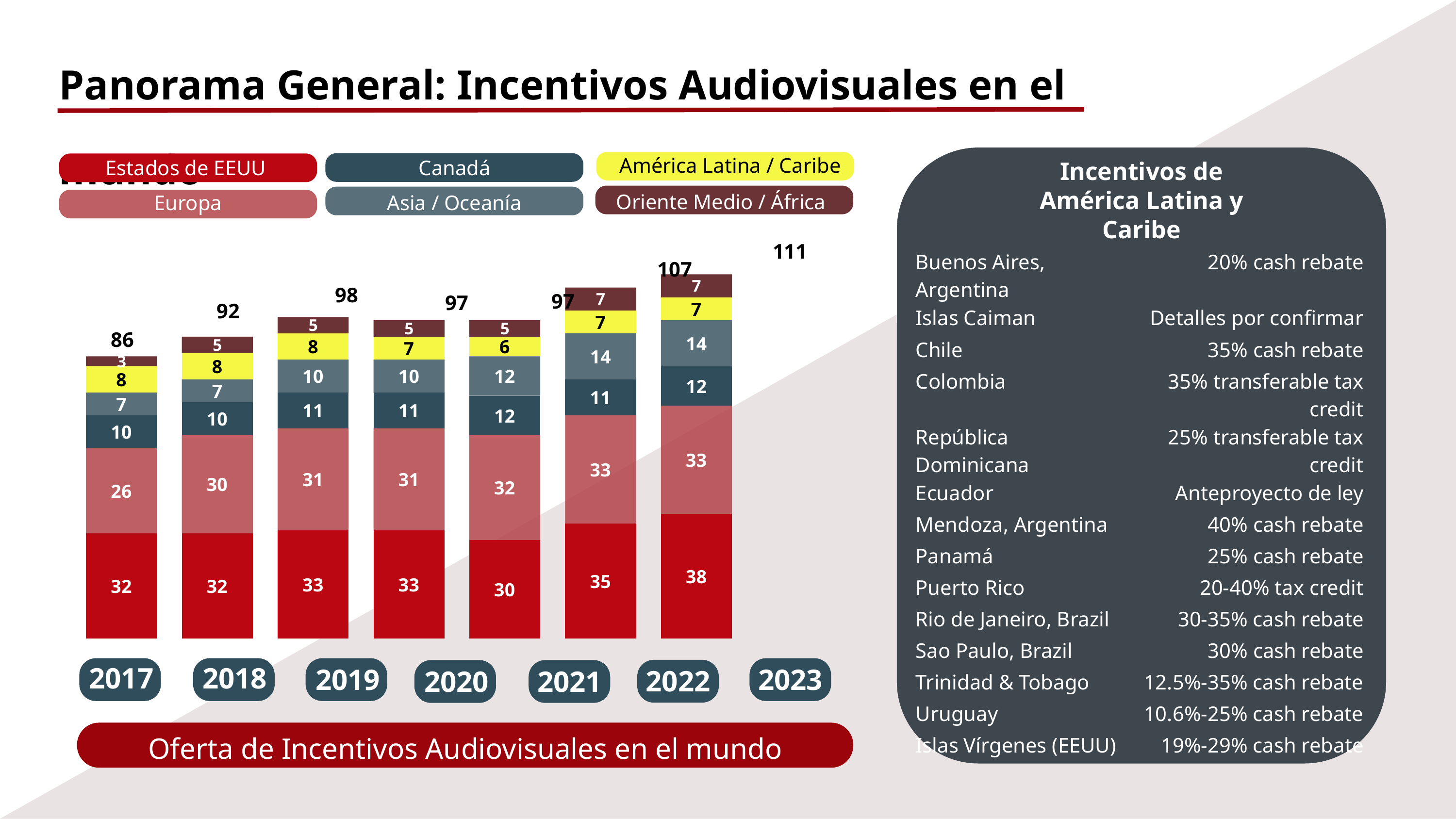
In the bar chart, what is the value of the Estados de EEUU segment in the first (leftmost) bar, labelled 2017? 32 How many series does the legend of the bar chart list? 6 In the bar chart, what is the value of the Europa segment in the first (leftmost) bar, labelled 2017? 26 What is the lowest total printed on the bar chart? 86 In the bar chart, what is the value of the Estados de EEUU segment in the rightmost bar? 38 What kind of chart is shown on the left of the slide? stacked bar chart Do the bar totals generally rise or fall from left to right across the chart? rise In the rightmost bar, which is larger: the Estados de EEUU segment or the Europa segment? Estados de EEUU How many stacked bars are plotted in the chart? 6 What is the highest total printed on the bar chart? 111 In the bar chart, what is the value of the Oriente Medio / África segment in the first (leftmost) bar, labelled 2017? 3 What is the total printed above the first (leftmost) bar, labelled 2017? 86